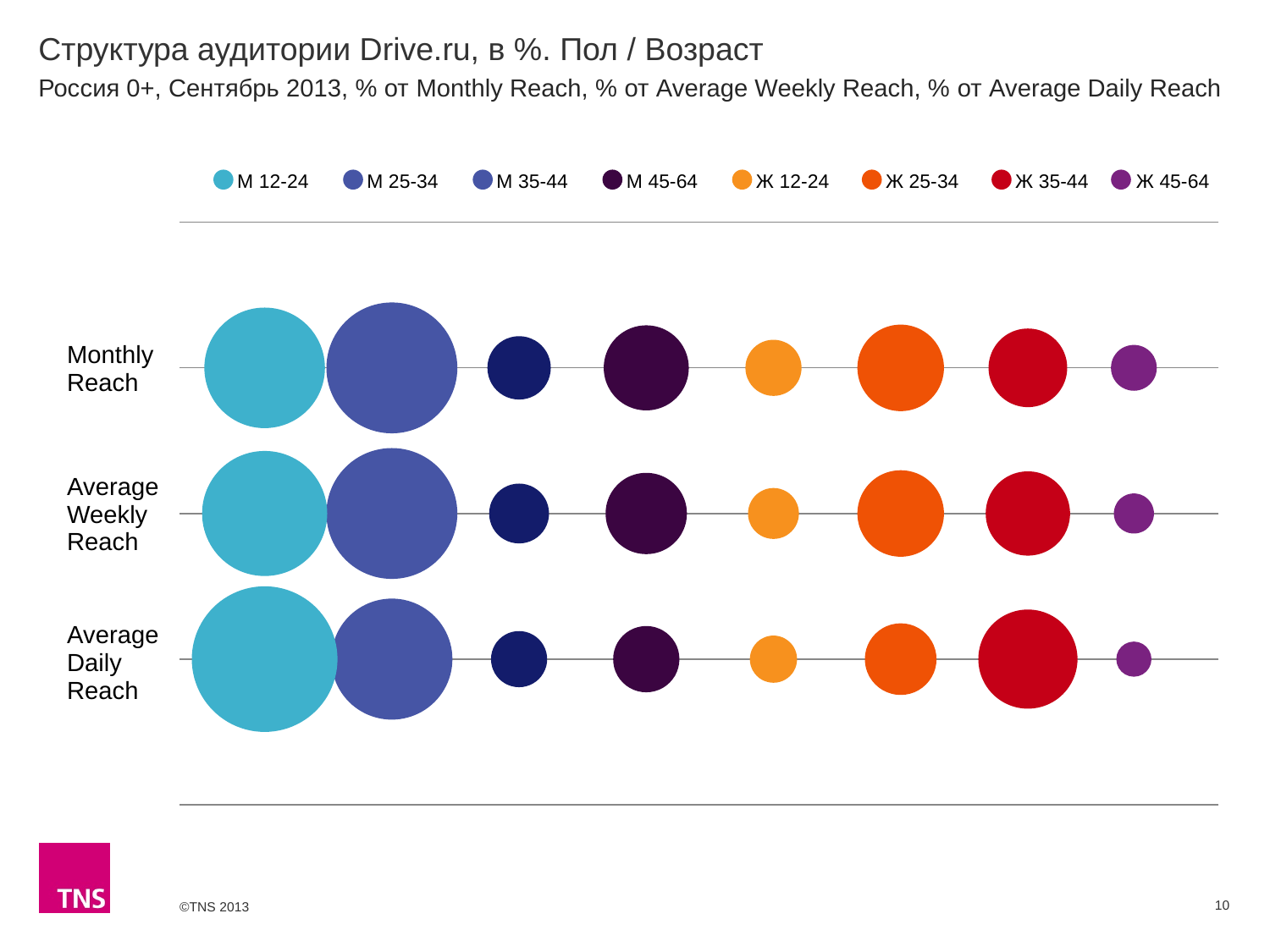
Which series has the smallest bubble in the Monthly Reach row? Ж 45-64 What is the label of the first (top) row of the chart? Monthly Reach Which legend entry is shown in red? Ж 35-44 Which series has the largest bubble in the Average Daily Reach row? М 12-24 In the Average Daily Reach row, which bubble is larger: Ж 35-44 or Ж 45-64? Ж 35-44 Does the bubble for М 12-24 get larger or smaller going from Monthly Reach down to Average Daily Reach? Larger How many reach categories (rows) are plotted on the chart? 3 How many series does the legend list? 8 Which series has the smallest bubble in the Average Daily Reach row? Ж 45-64 What kind of chart is shown on the slide? Bubble chart In the Average Weekly Reach row, which bubble is larger: М 35-44 or М 45-64? М 45-64 In the Monthly Reach row, which bubble is larger: Ж 12-24 or Ж 25-34? Ж 25-34